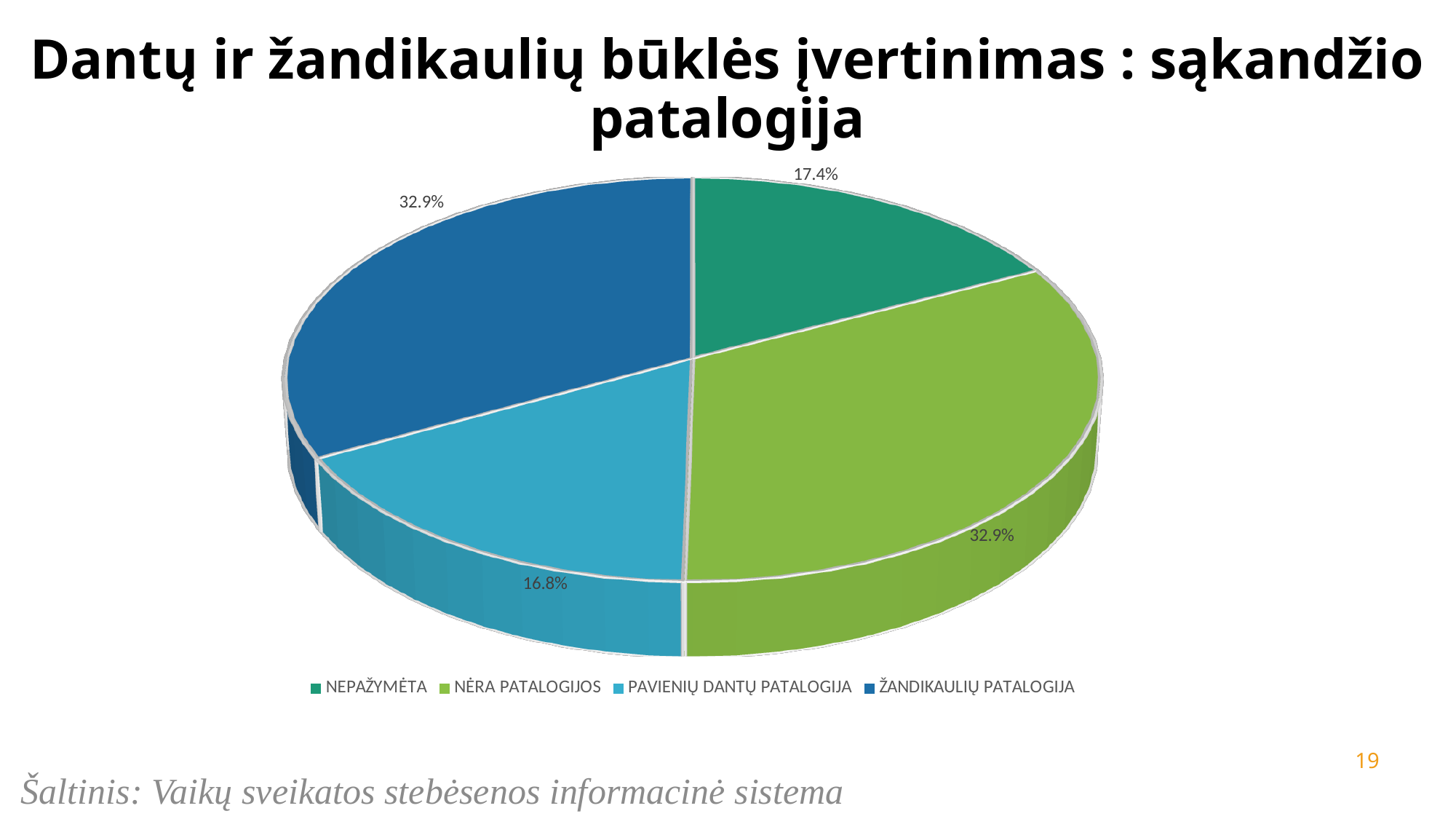
What percentage of the pie is NEPAŽYMĖTA? 17.4% What colour is the ŽANDIKAULIŲ PATALOGIJA slice? dark blue What percentage of the pie is ŽANDIKAULIŲ PATALOGIJA? 32.9% What kind of chart is shown on the slide? pie chart What is the difference in percentage points between the NEPAŽYMĖTA slice and the PAVIENIŲ DANTŲ PATALOGIJA slice? 0.6 What percentage of the pie is PAVIENIŲ DANTŲ PATALOGIJA? 16.8% What is the difference in percentage points between the NĖRA PATALOGIJOS slice and the NEPAŽYMĖTA slice? 15.5 How many slices does the pie chart have? 4 How many entries does the legend list? 4 Which category has the smallest slice of the pie? PAVIENIŲ DANTŲ PATALOGIJA What percentage of the pie is NĖRA PATALOGIJOS? 32.9% Which is larger: the slice for NEPAŽYMĖTA or the slice for PAVIENIŲ DANTŲ PATALOGIJA? NEPAŽYMĖTA